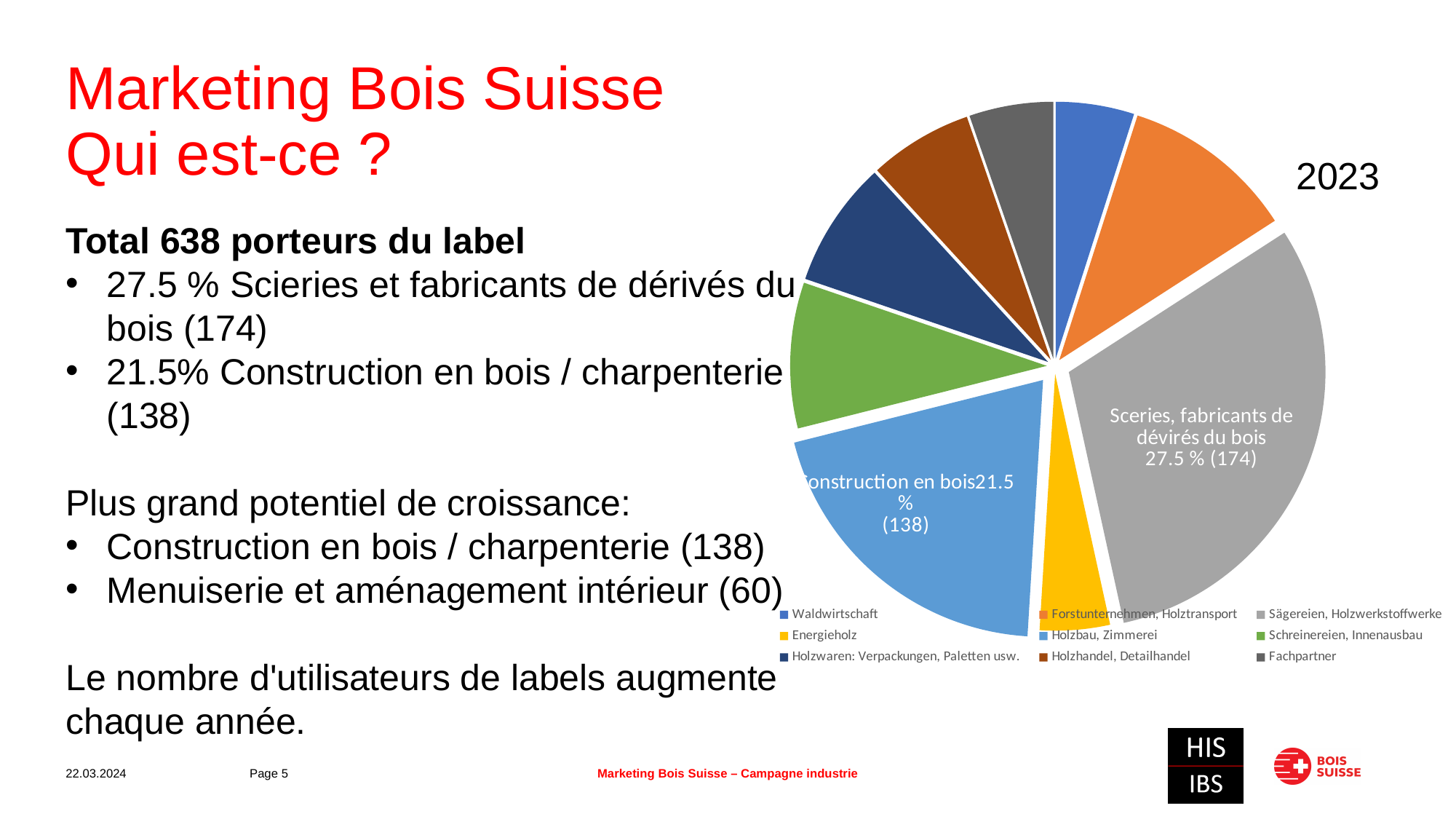
How many categories does the legend of the pie chart list? 9 What is the difference between the counts shown for Sceries, fabricants de dévirés du bois (174) and Construction en bois (138)? 36 What count is shown in parentheses on the slice for Construction en bois? 138 Which year is shown next to the pie chart? 2023 Which slice is larger: Sägereien, Holzwerkstoffwerke or Holzbau, Zimmerei? Sägereien, Holzwerkstoffwerke What count is shown in parentheses on the slice for Sceries, fabricants de dévirés du bois? 174 Which category has the largest slice in the pie chart? Sägereien, Holzwerkstoffwerke What colour is the Holzbau, Zimmerei slice in the pie chart? light blue What percentage is shown on the slice for Construction en bois? 21.5 % What percentage is shown on the slice for Sceries, fabricants de dévirés du bois? 27.5 % What kind of chart is shown on the slide? pie chart Which slice is larger: Schreinereien, Innenausbau or Waldwirtschaft? Schreinereien, Innenausbau